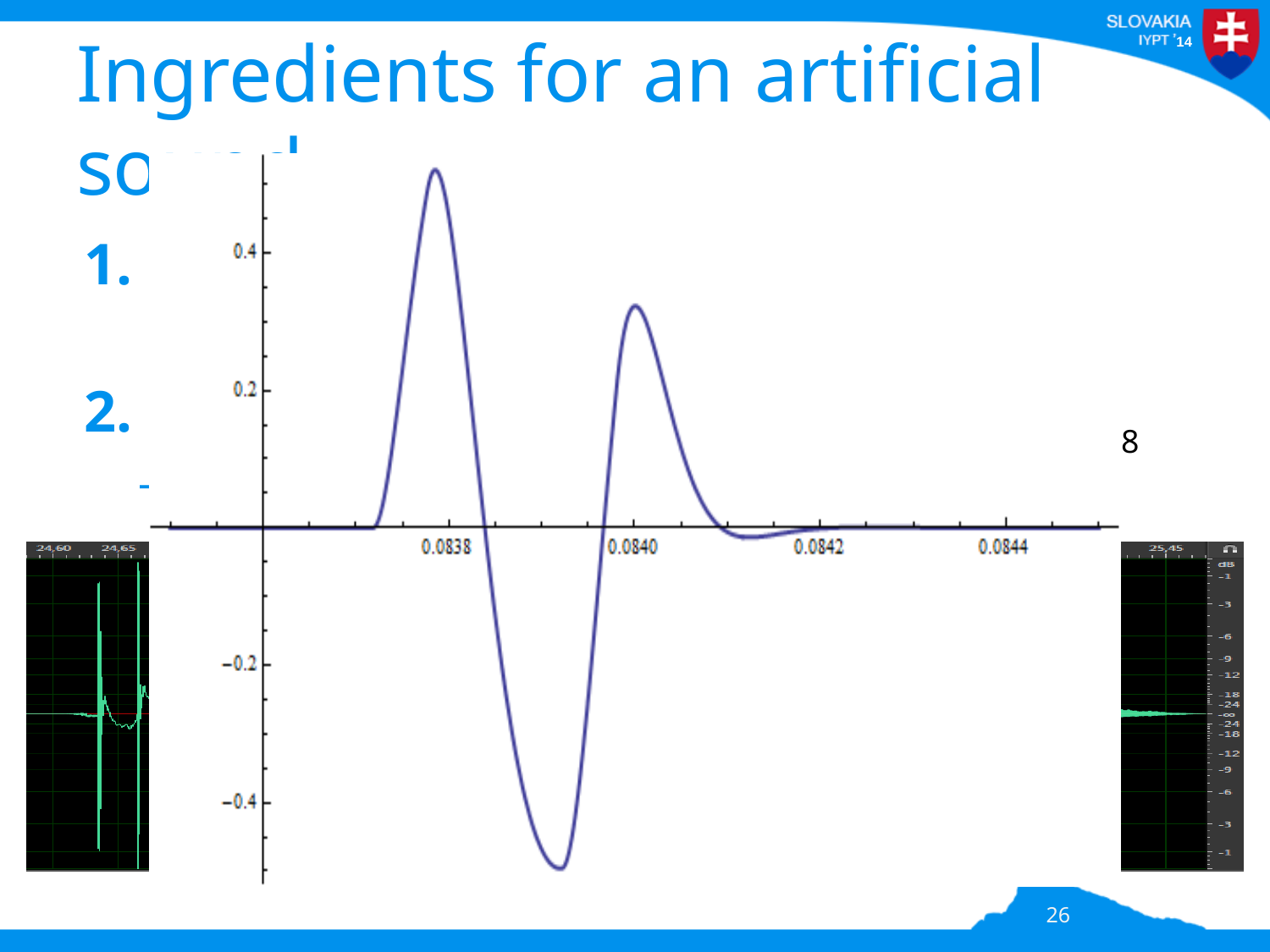
In the large central chart, is the curve's value at x = 0.0844 greater or less than 0.2? less In the large central chart, is the value at the lowest point of the curve greater or less than -0.4? less In the large central chart, which positive peak is higher: the first one (near 0.0838) or the second one (near 0.0840)? the first one (near 0.0838) What is the highest tick label shown on the y axis of the large central chart? 0.4 What kind of chart is the large central plot on the slide? line chart In the large central chart, is the value at the second positive peak (near 0.0840) greater or less than 0.4? less How many curves are plotted in the large central chart? 1 What is the largest tick label shown on the x axis of the large central chart? 0.0844 How many positive peaks does the curve in the large central chart have? 2